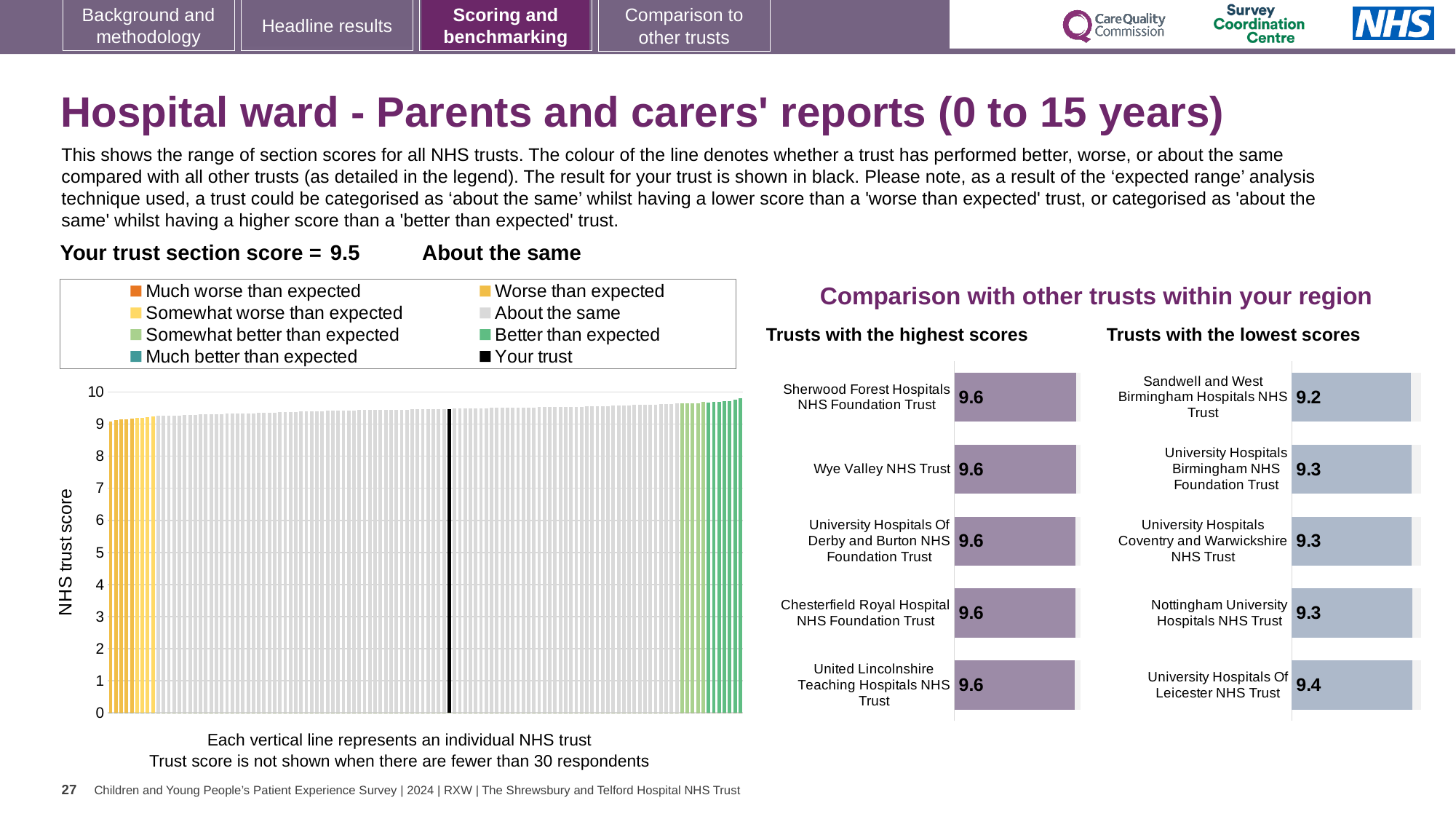
How many entries does the legend of the main NHS trust score chart list? 8 What kind of chart is the main chart on the left showing the range of section scores? bar chart In the 'Trusts with the lowest scores' chart, which trust has the lowest score? Sandwell and West Birmingham Hospitals NHS Trust Comparing the two regional charts, which has the higher score: Wye Valley NHS Trust or Nottingham University Hospitals NHS Trust? Wye Valley NHS Trust In the 'Trusts with the highest scores' chart, what is the score for Wye Valley NHS Trust? 9.6 In the 'Trusts with the lowest scores' chart, what is the score for University Hospitals Of Leicester NHS Trust? 9.4 In the main chart on the left, is the value for your trust (the black line) greater or less than 8? greater What is the y-axis label of the main chart on the left? NHS trust score How many trusts are shown in the 'Trusts with the highest scores' chart? 5 In the 'Trusts with the lowest scores' chart, what is the score for Sandwell and West Birmingham Hospitals NHS Trust? 9.2 In the 'Trusts with the lowest scores' chart, which trust has the highest score? University Hospitals Of Leicester NHS Trust In the 'Trusts with the lowest scores' chart, what is the difference between the scores of University Hospitals Of Leicester NHS Trust and Sandwell and West Birmingham Hospitals NHS Trust? 0.2